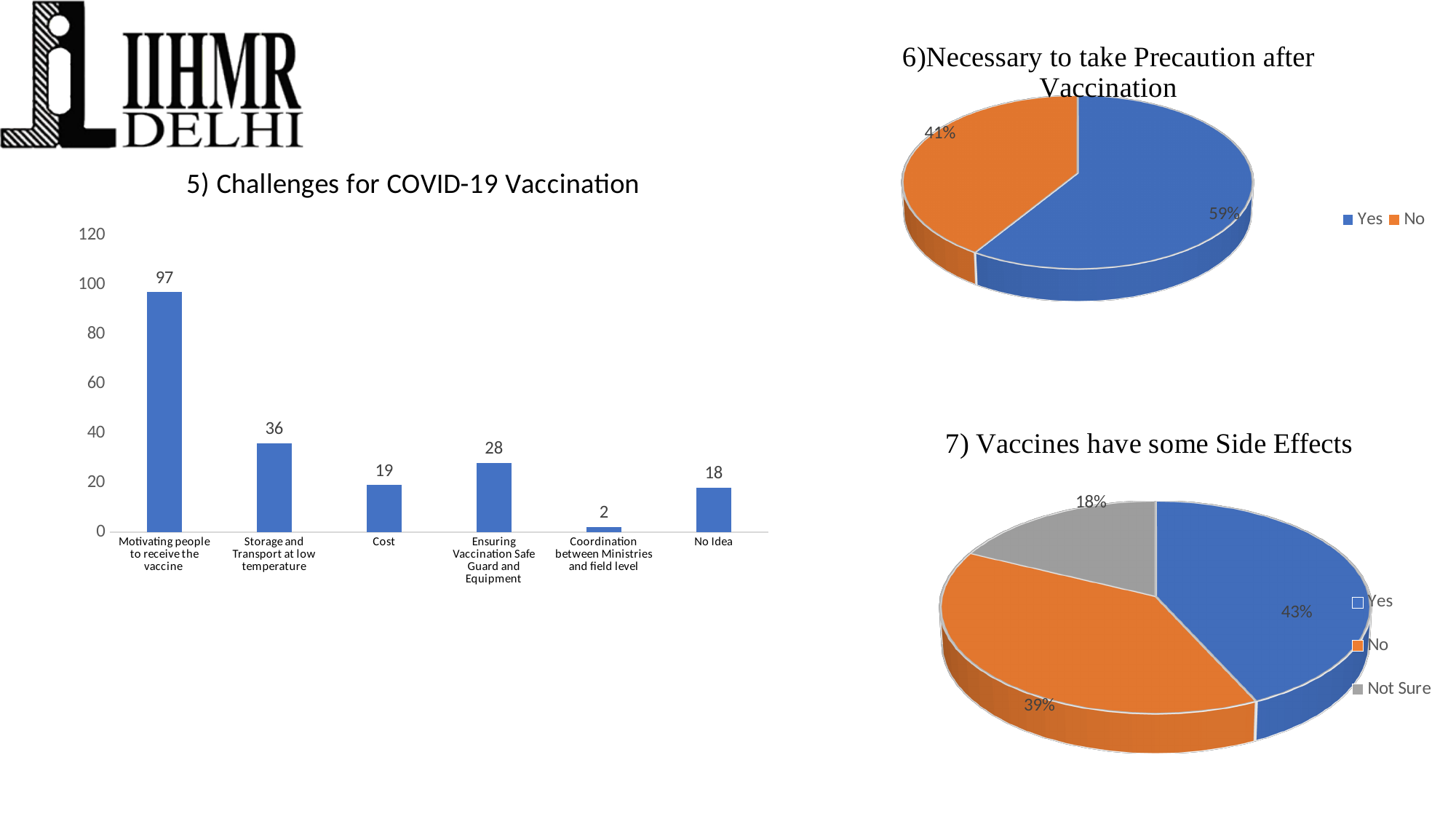
In the '6)Necessary to take Precaution after Vaccination' chart, which slice is larger: Yes or No? Yes How many categories are shown in the '5) Challenges for COVID-19 Vaccination' chart? 6 In the '6)Necessary to take Precaution after Vaccination' chart, what share of the pie is 'No'? 41% In the '5) Challenges for COVID-19 Vaccination' chart, what is the value for Cost? 19 In the '5) Challenges for COVID-19 Vaccination' chart, which category has the lowest value? Coordination between Ministries and field level In the '5) Challenges for COVID-19 Vaccination' chart, which is larger: Ensuring Vaccination Safe Guard and Equipment or Cost? Ensuring Vaccination Safe Guard and Equipment In the '5) Challenges for COVID-19 Vaccination' chart, which category has the highest value? Motivating people to receive the vaccine In the '7) Vaccines have some Side Effects' chart, what is the difference between the Yes and No shares? 4% In the '7) Vaccines have some Side Effects' chart, what share of the pie is 'Not Sure'? 18% How many entries does the legend of the '7) Vaccines have some Side Effects' chart list? 3 What kind of chart is '5) Challenges for COVID-19 Vaccination'? Bar chart In the '5) Challenges for COVID-19 Vaccination' chart, what is the difference between the values for Storage and Transport at low temperature and No Idea? 18